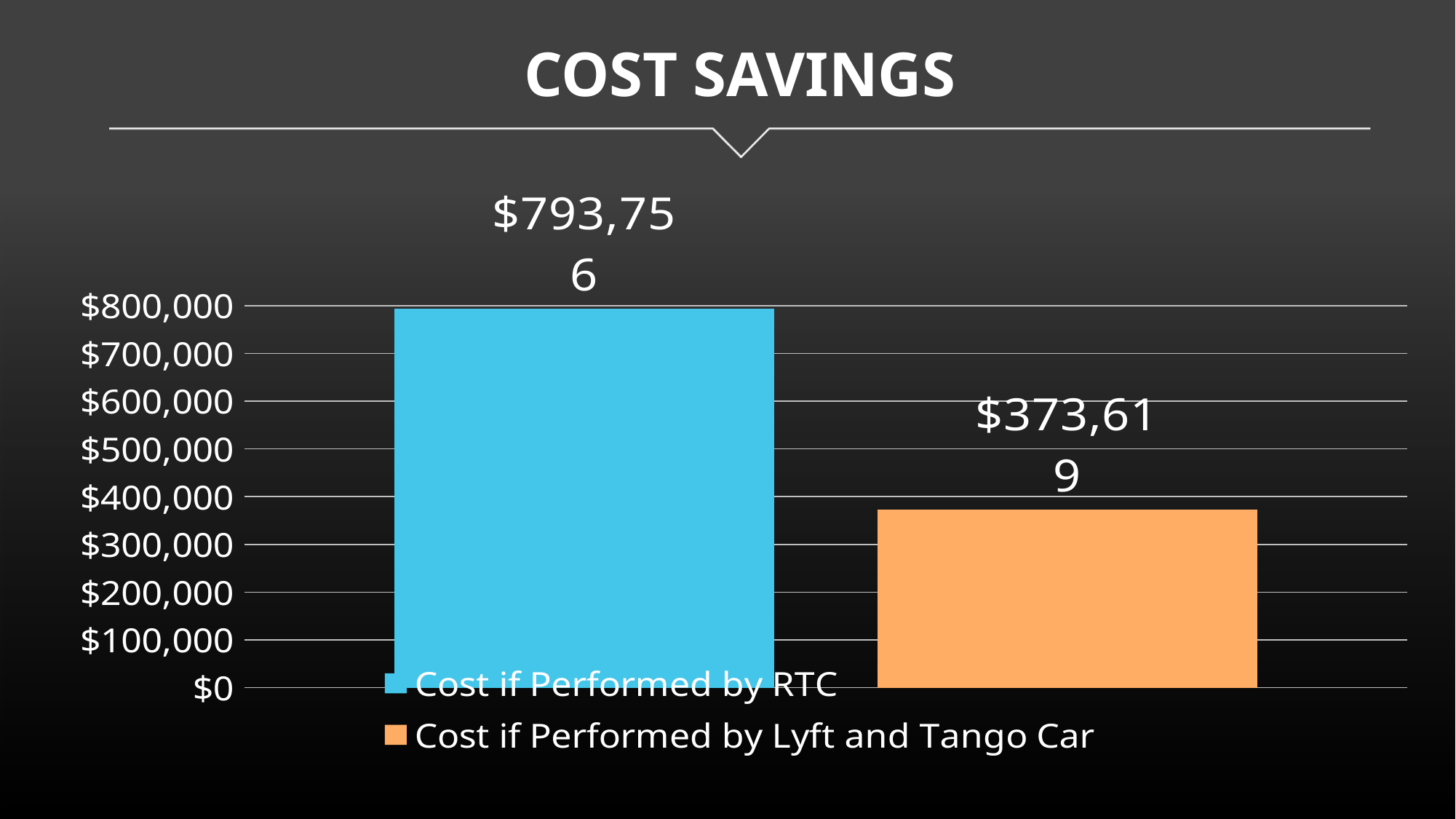
What is the difference between the cost if performed by RTC and the cost if performed by Lyft and Tango Car? $420,137 What is the value for Cost if Performed by RTC? $793,756 What is the title of the slide? COST SAVINGS Which is larger: the cost if performed by Lyft and Tango Car or the cost if performed by RTC? Cost if Performed by RTC Which series has the higher value? Cost if Performed by RTC Is the value for Cost if Performed by RTC greater or less than $700,000? greater How many bars are plotted on the chart? 2 How many series does the legend list? 2 What kind of chart is shown on the slide? Bar chart Which series has the lower value? Cost if Performed by Lyft and Tango Car Is the value for Cost if Performed by Lyft and Tango Car greater or less than $400,000? less What is the value for Cost if Performed by Lyft and Tango Car? $373,619